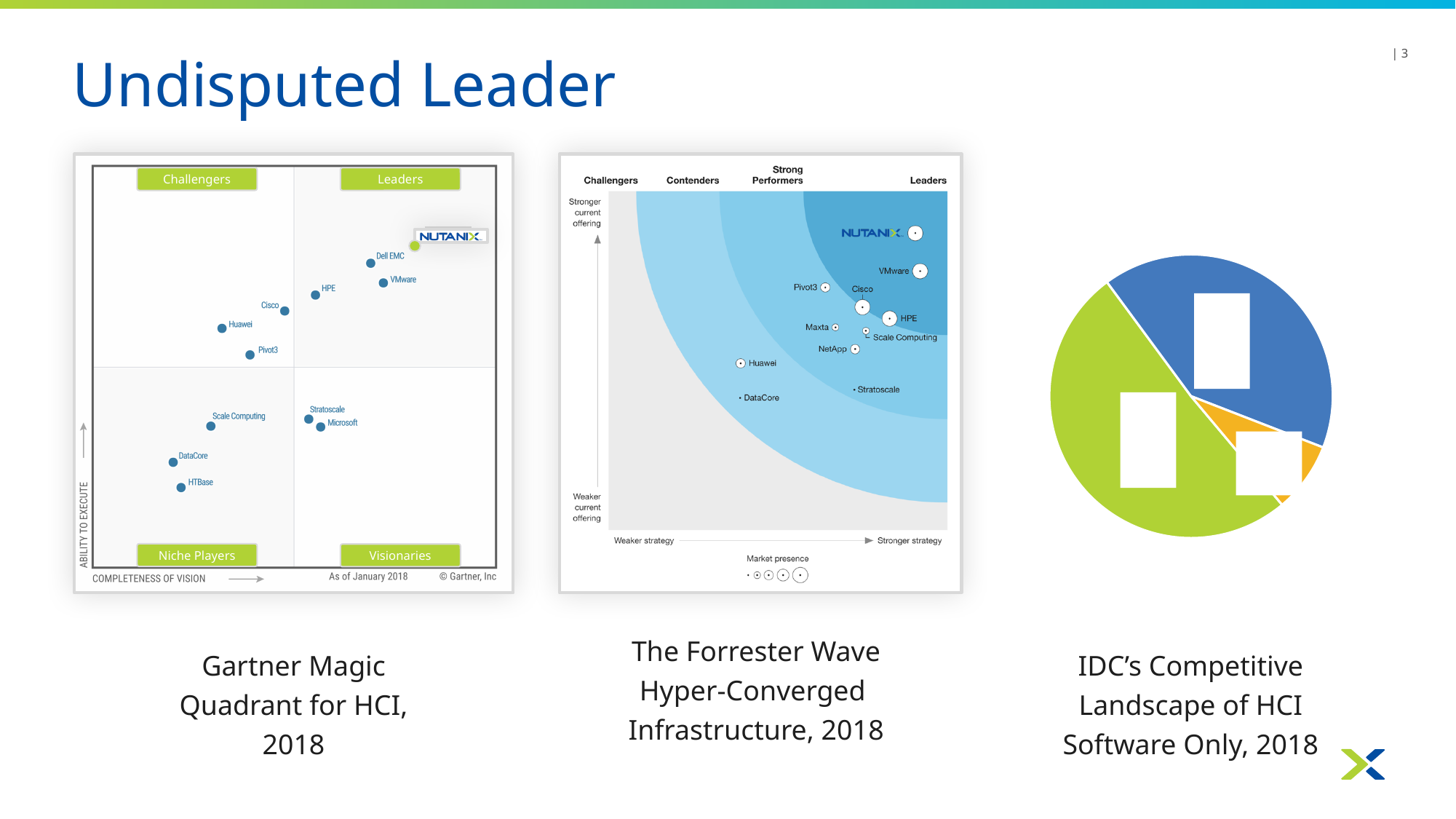
What kind of chart is the IDC's Competitive Landscape of HCI Software Only, 2018 chart on the right of the slide? Pie chart In the Gartner Magic Quadrant chart, which is lower on Ability to Execute, Huawei or Pivot3? Pivot3 In the IDC pie chart on the right, which colour slice is the smallest? Orange In the Forrester Wave chart, which has the stronger strategy, Huawei or Stratoscale? Stratoscale In the Gartner Magic Quadrant chart, which vendors are plotted in the Visionaries quadrant? Stratoscale and Microsoft In the Gartner Magic Quadrant chart, which quadrant is Nutanix plotted in? Leaders What kind of chart is the Gartner Magic Quadrant for HCI, 2018 on the left of the slide? Scatter plot In the Gartner Magic Quadrant chart, which is higher on Ability to Execute, Dell EMC or VMware? Dell EMC In the Forrester Wave chart in the middle of the slide, which vendor has the strongest current offering? Nutanix How many vendors are plotted in the Forrester Wave chart? 11 In the Gartner Magic Quadrant chart, which vendor is highest on Ability to Execute? Nutanix How many vendors are plotted in the Gartner Magic Quadrant chart? 12